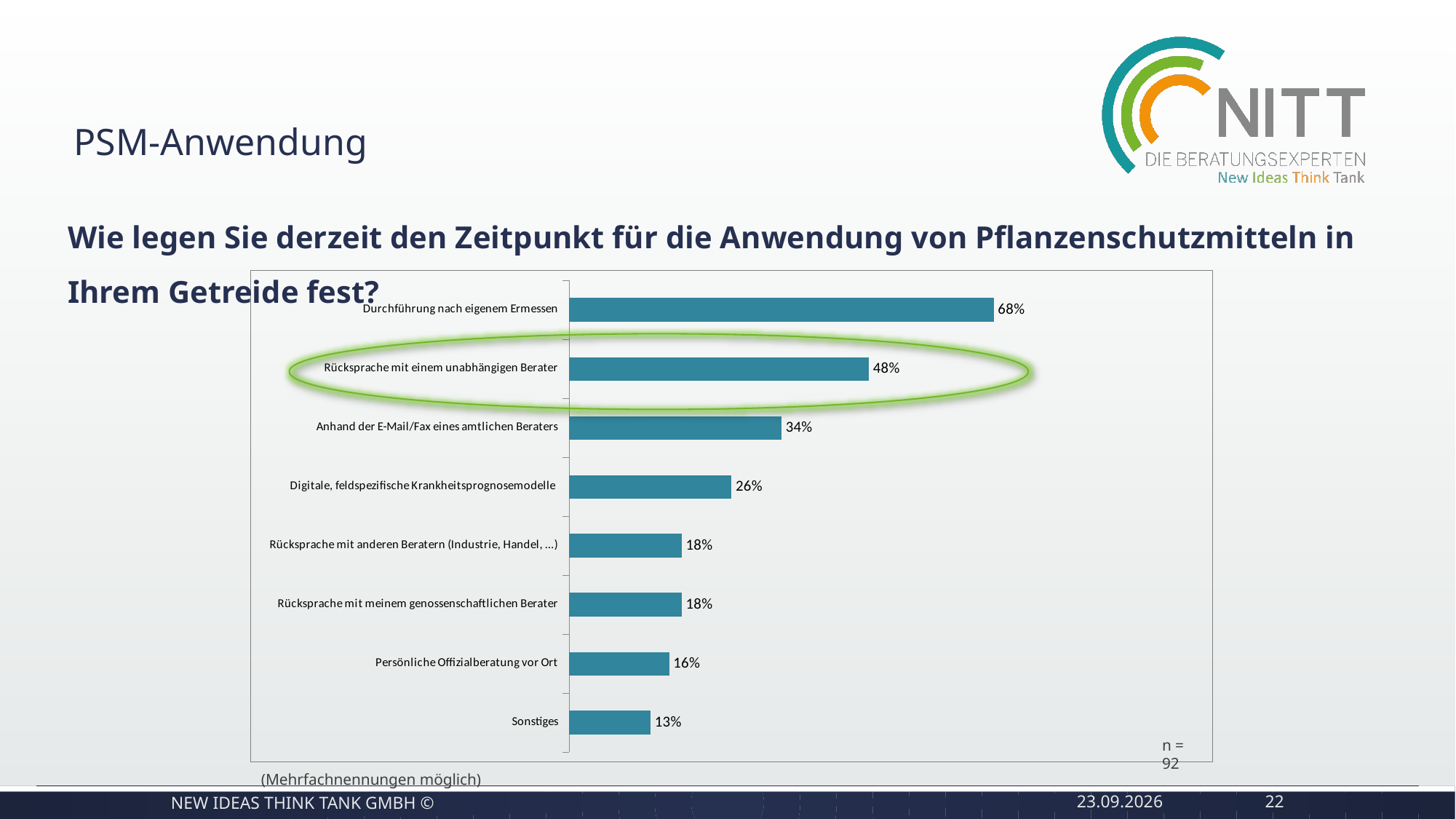
What kind of chart is shown on the slide? Bar chart What percentage is shown for "Digitale, feldspezifische Krankheitsprognosemodelle"? 26% Which category is highlighted with a green ellipse? Rücksprache mit einem unabhängigen Berater What value is shown for "Sonstiges"? 13% What percentage is shown for "Durchführung nach eigenem Ermessen"? 68% What value is shown for "Rücksprache mit einem unabhängigen Berater"? 48% Which category has the highest value? Durchführung nach eigenem Ermessen What is the difference between "Durchführung nach eigenem Ermessen" and "Rücksprache mit einem unabhängigen Berater"? 20 percentage points Which is larger: "Anhand der E-Mail/Fax eines amtlichen Beraters" or "Persönliche Offizialberatung vor Ort"? Anhand der E-Mail/Fax eines amtlichen Beraters Which category has the lowest value? Sonstiges How many categories are shown in the chart? 8 What sample size (n) is given for the chart? 92